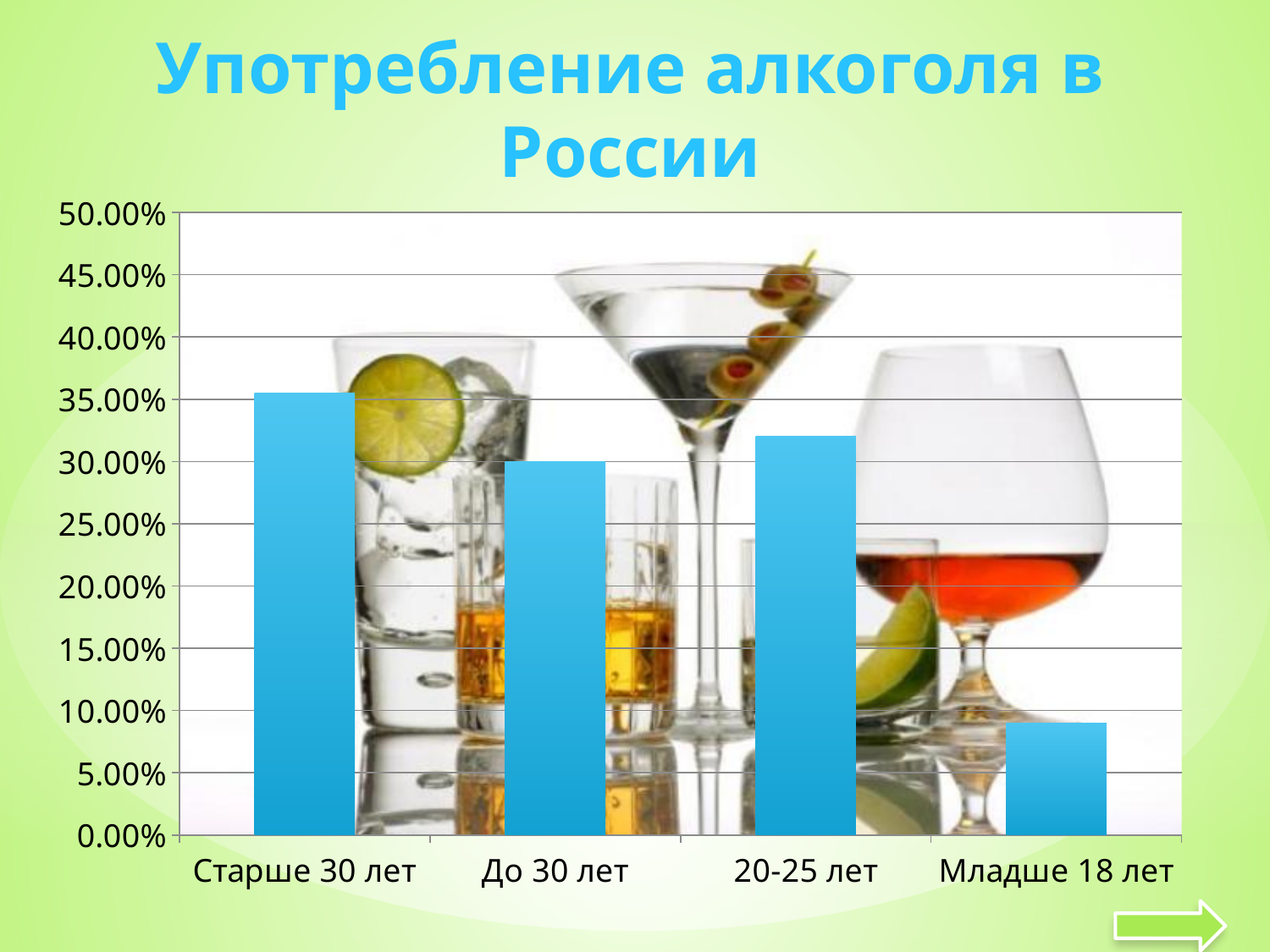
Which age category has the highest value? Старше 30 лет Which age category has the lowest value? Младше 18 лет What is the value for До 30 лет? 30.00% Which is larger, the value for Старше 30 лет or the value for 20-25 лет? Старше 30 лет What is the title of the chart? Употребление алкоголя в России Is the value for Старше 30 лет greater or less than 30.00%? greater How many age categories are shown on the x axis? 4 Is the value for 20-25 лет greater or less than 35.00%? less Is the value for Младше 18 лет greater or less than 10.00%? less Which is larger, the value for До 30 лет or the value for 20-25 лет? 20-25 лет What kind of chart is shown on the slide? bar chart